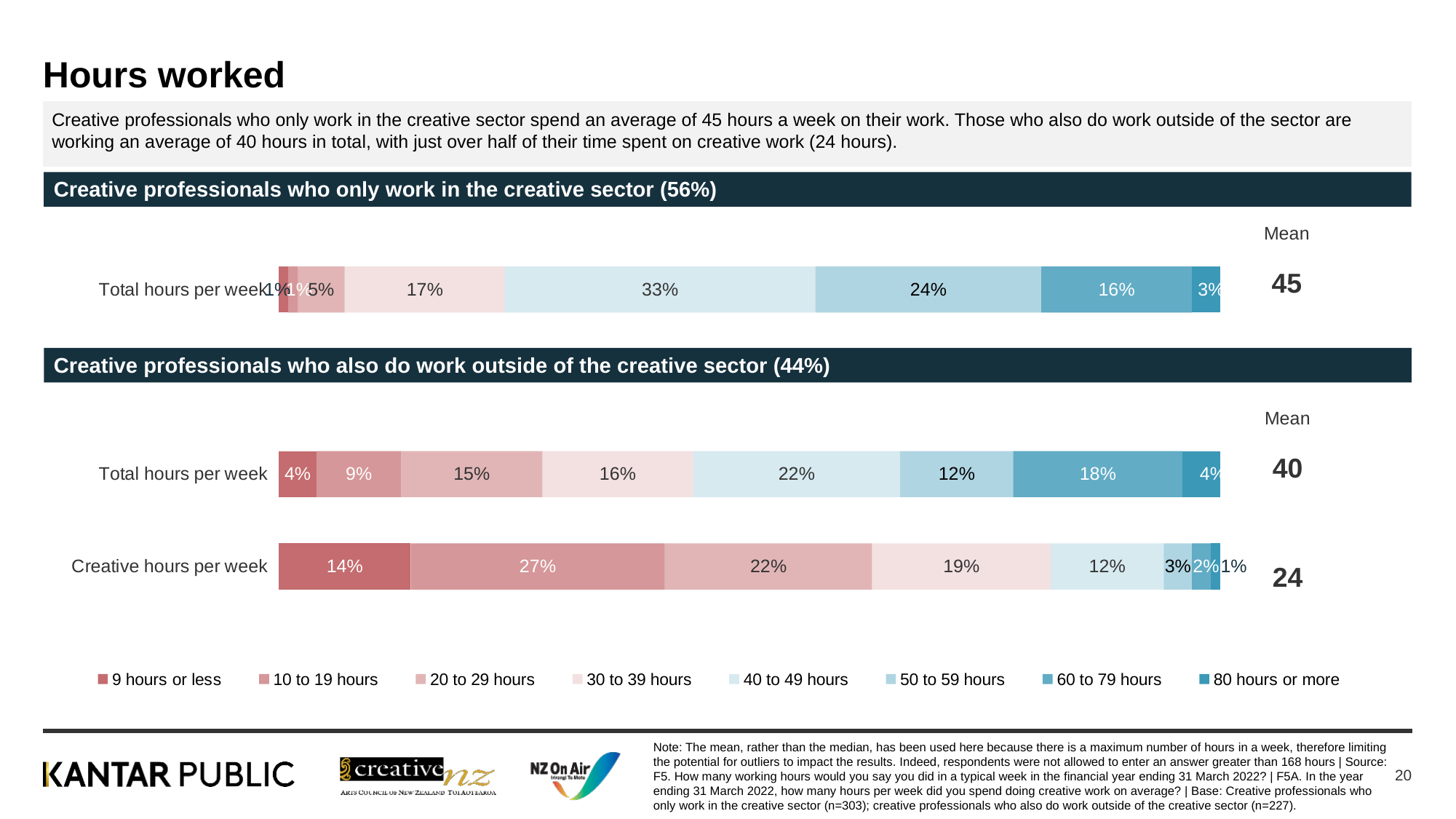
In the chart for creative professionals who also do work outside of the creative sector, which hours band has the largest share of the 'Creative hours per week' bar? 10 to 19 hours In the chart for creative professionals who only work in the creative sector, what is the mean total hours per week? 45 In the chart for creative professionals who only work in the creative sector, what percentage work 40 to 49 hours per week? 33% In the chart for creative professionals who also do work outside of the creative sector, which is larger for 'Total hours per week': the 20 to 29 hours share or the 30 to 39 hours share? 30 to 39 hours How many bars are in the chart for creative professionals who also do work outside of the creative sector? 2 How many hours bands does the legend list? 8 In the chart for creative professionals who also do work outside of the creative sector, what is the difference between the 40 to 49 hours share of 'Total hours per week' and the 40 to 49 hours share of 'Creative hours per week'? 10% What type of chart is used on this slide? Stacked bar chart In the chart for creative professionals who also do work outside of the creative sector, what is the mean for 'Creative hours per week'? 24 In the chart for creative professionals who also do work outside of the creative sector, what percentage of the 'Total hours per week' bar is 60 to 79 hours? 18% In the chart for creative professionals who also do work outside of the creative sector, what percentage of the 'Creative hours per week' bar is 10 to 19 hours? 27% In the chart for creative professionals who only work in the creative sector, which hours band has the largest share? 40 to 49 hours